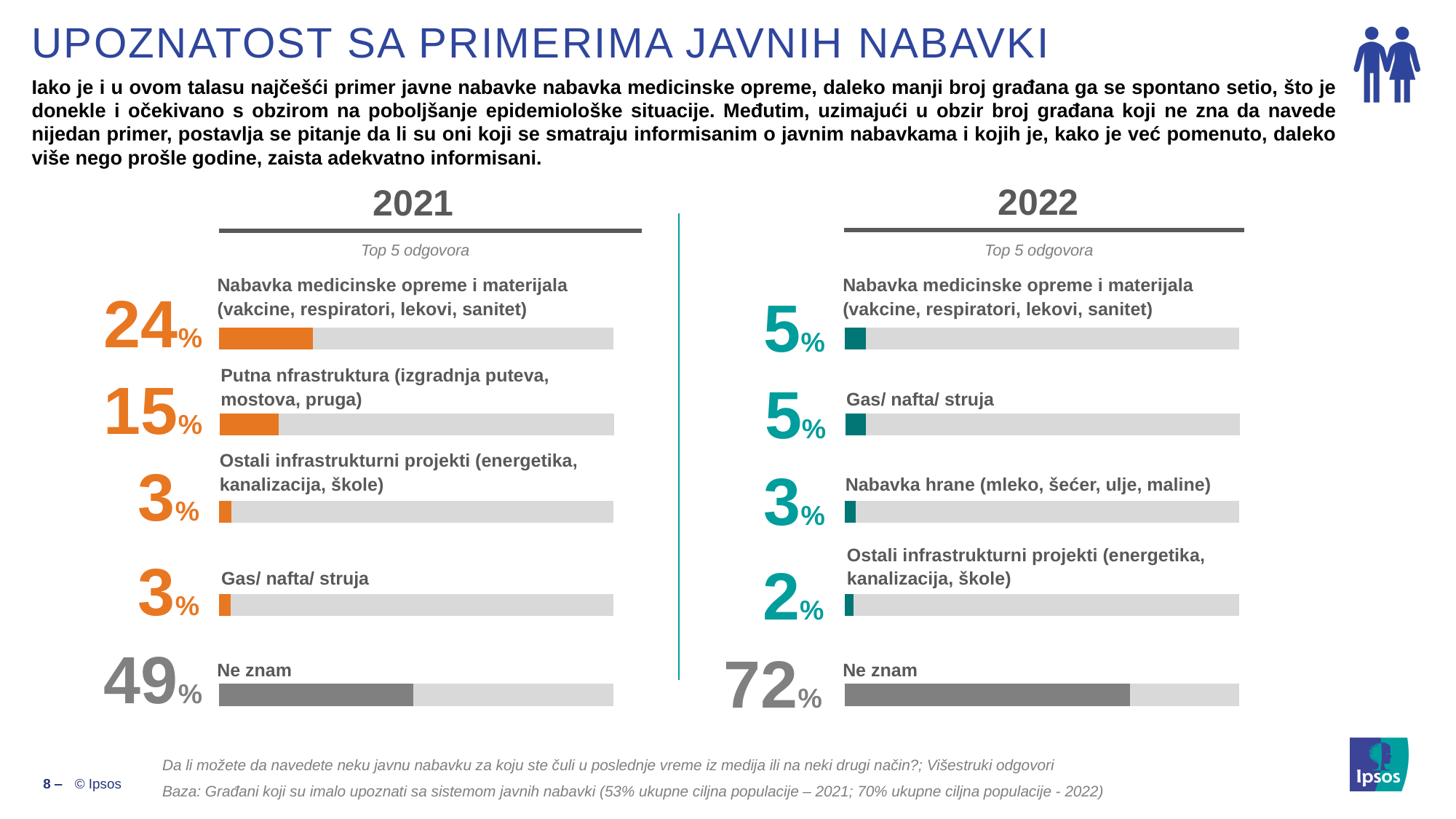
What kind of chart is the 2021 chart? Bar chart How many categories are shown in the 2022 chart? 5 In the 2021 chart, what is the value for "Nabavka medicinske opreme i materijala"? 24% In the 2022 chart, what is the value for "Nabavka hrane (mleko, šećer, ulje, maline)"? 3% What colour are the bars for the top 4 answers in the 2021 chart? Orange In the 2021 chart, which category has the highest value? Ne znam What is the difference between the value for "Nabavka medicinske opreme i materijala" in the 2021 chart and in the 2022 chart? 19% What is the difference between the "Ne znam" value in the 2022 chart and the "Ne znam" value in the 2021 chart? 23% In the 2022 chart, which category has the lowest value? Ostali infrastrukturni projekti (energetika, kanalizacija, škole) Which is larger: "Gas/ nafta/ struja" in the 2021 chart or "Gas/ nafta/ struja" in the 2022 chart? 2022 In the 2022 chart, what is the value for "Ne znam"? 72% In the 2021 chart, what is the value for "Putna nfrastruktura (izgradnja puteva, mostova, pruga)"? 15%